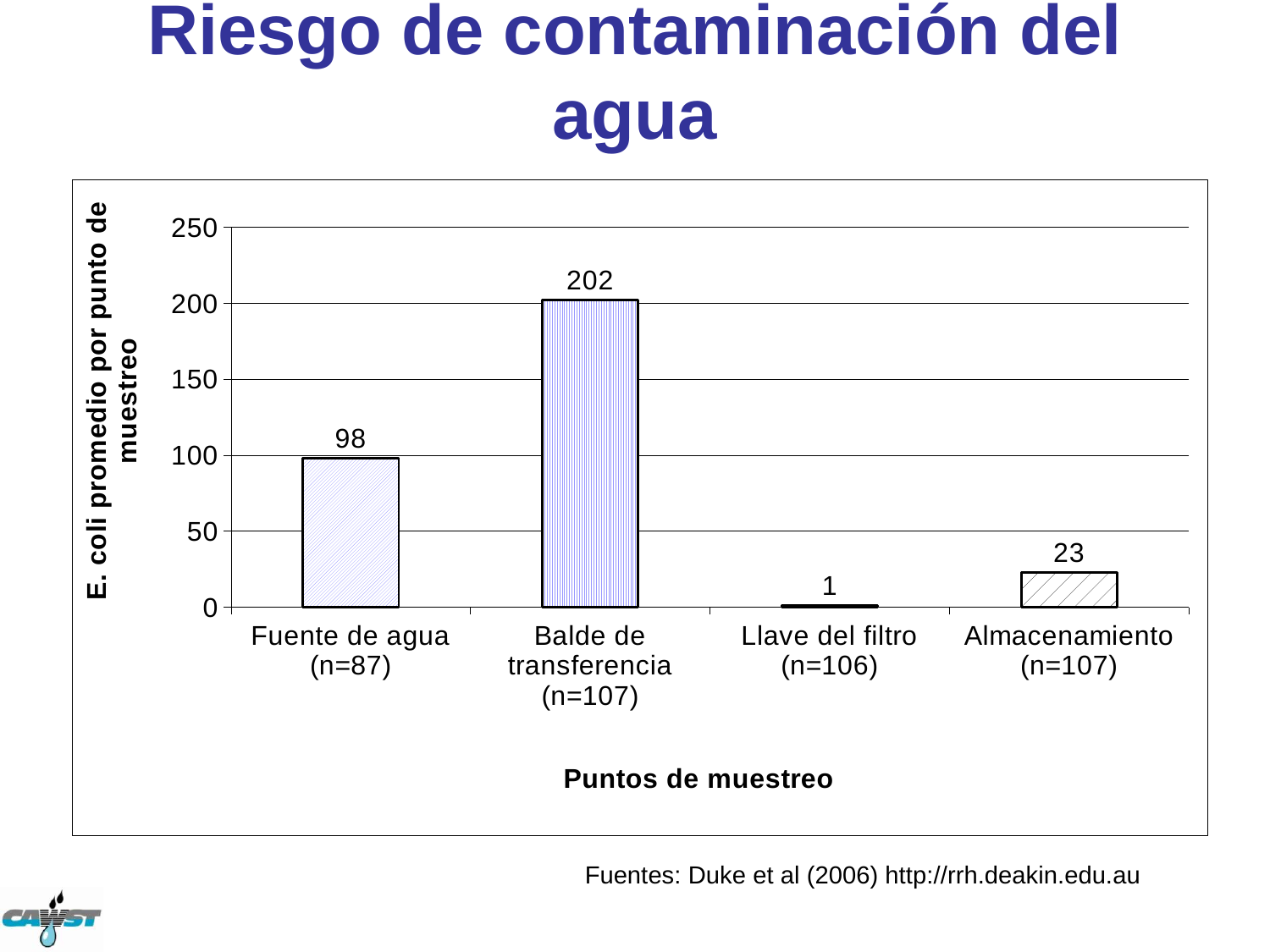
Which is larger, the value for Fuente de agua or the value for Almacenamiento? Fuente de agua What is the average E. coli value for Llave del filtro (n=106)? 1 What is the difference between the values for Balde de transferencia and Fuente de agua? 104 Is the value for Balde de transferencia greater or less than 150? greater What is the difference between the values for Almacenamiento and Llave del filtro? 22 How many sampling points are shown on the x axis? 4 Which sampling point has the highest average E. coli value? Balde de transferencia (n=107) What kind of chart is shown on the slide? Bar chart Which sampling point has the lowest average E. coli value? Llave del filtro (n=106) What is the average E. coli value for Almacenamiento (n=107)? 23 What is the average E. coli value for Balde de transferencia (n=107)? 202 What is the average E. coli value for Fuente de agua (n=87)? 98